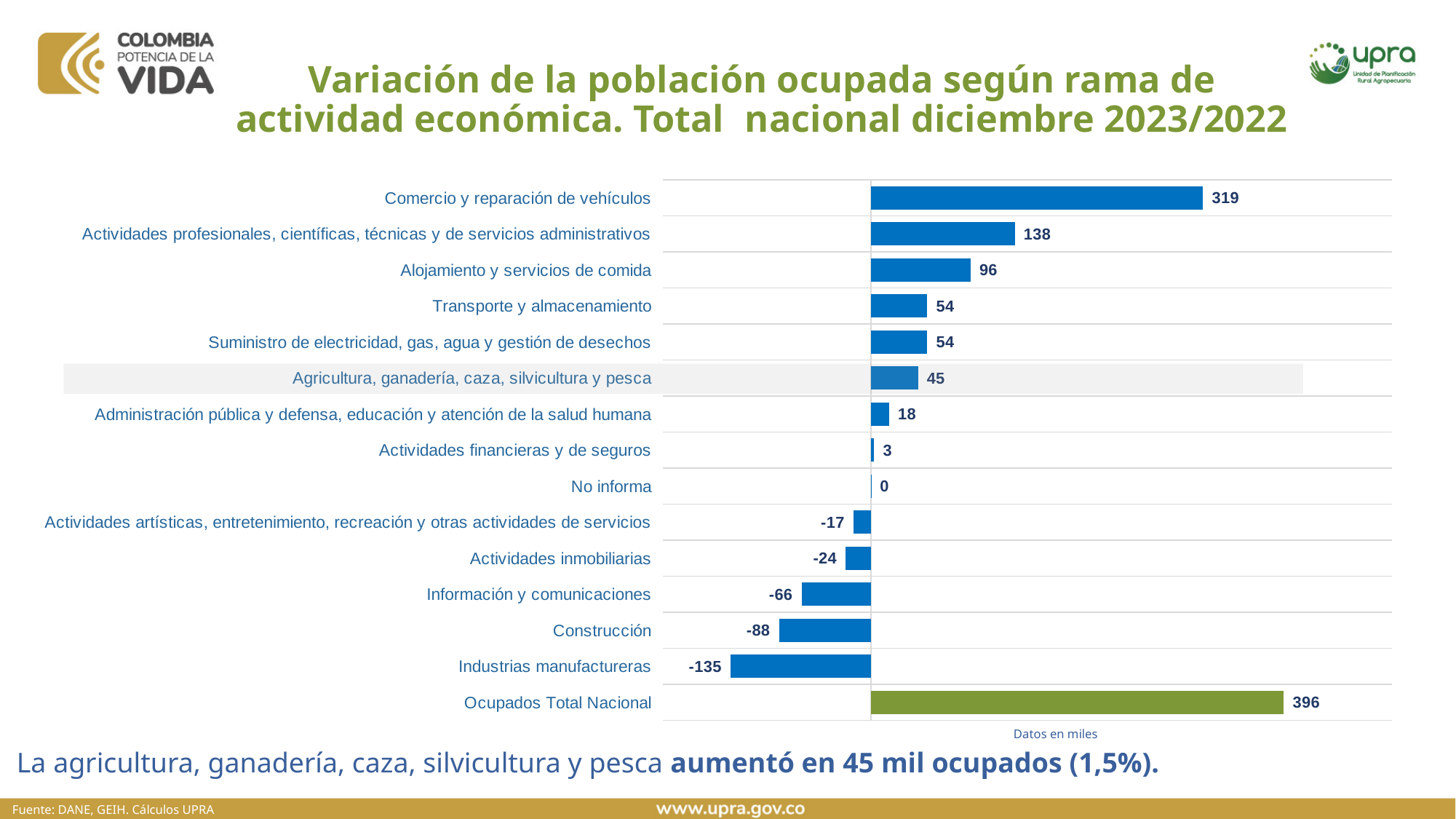
Which category has the highest value? Ocupados Total Nacional What is the value for Agricultura, ganadería, caza, silvicultura y pesca? 45 What is the difference between the values for Alojamiento y servicios de comida and Transporte y almacenamiento? 42 What is the value for Industrias manufactureras? -135 What is the value for Ocupados Total Nacional? 396 Which category has the lowest value? Industrias manufactureras What colour is the bar for Ocupados Total Nacional? Green What is the difference between the values for Comercio y reparación de vehículos and Actividades profesionales, científicas, técnicas y de servicios administrativos? 181 Which is larger, the value for Construcción or the value for Información y comunicaciones? Información y comunicaciones What is the value for Comercio y reparación de vehículos? 319 How many categories are shown in the chart? 15 What kind of chart is shown on the slide? Bar chart